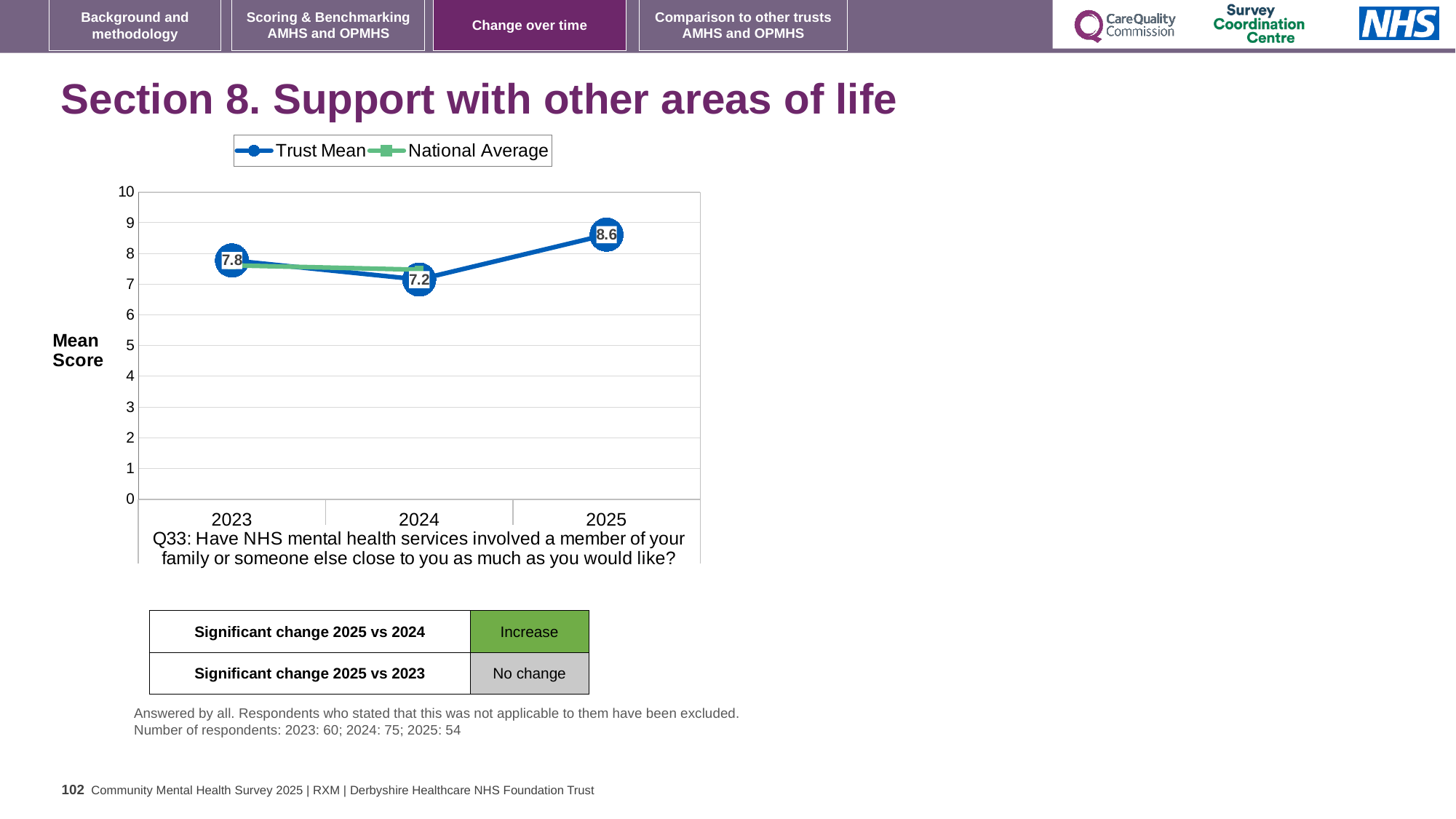
Which is larger, the Trust Mean for 2023 or for 2025? 2025 What is the Trust Mean score for 2023? 7.8 What kind of chart is shown on the slide? line chart What is the difference between the Trust Mean in 2025 and in 2024? 1.4 Is the Trust Mean for 2024 greater or less than 8? less What is the Trust Mean score for 2024? 7.2 In which year is the Trust Mean highest? 2025 Does the Trust Mean rise or fall from 2024 to 2025? rise How many series does the legend list? 2 What is the Trust Mean score for 2025? 8.6 How many years are shown on the x axis? 3 In which year is the Trust Mean lowest? 2024